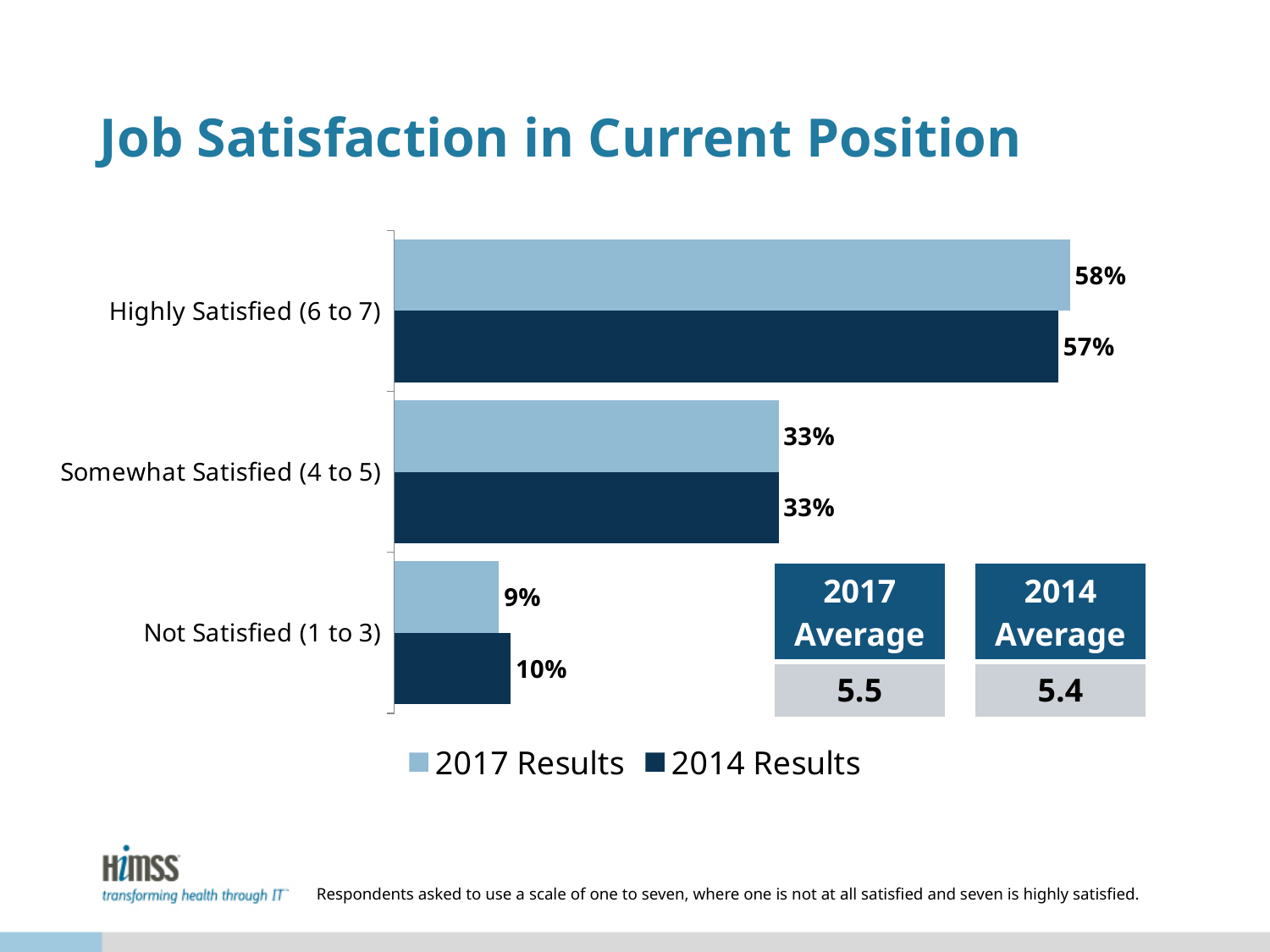
What percentage of respondents were Highly Satisfied (6 to 7) in the 2017 Results? 58% What is the difference between the 2017 and 2014 values for Highly Satisfied (6 to 7)? 1% What type of chart is shown on the slide? Bar chart Which satisfaction category has the highest value in the 2017 Results? Highly Satisfied (6 to 7) How many series does the legend list? 2 What is the 2017 Average job satisfaction score shown on the slide? 5.5 How many satisfaction categories are shown in the chart? 3 What percentage of respondents were Somewhat Satisfied (4 to 5) in the 2017 Results? 33% Which is larger for Not Satisfied (1 to 3): the 2017 Results or the 2014 Results? 2014 Results Which satisfaction category has the lowest value in the 2014 Results? Not Satisfied (1 to 3) What is the title of the chart on the slide? Job Satisfaction in Current Position What percentage of respondents were Not Satisfied (1 to 3) in the 2014 Results? 10%